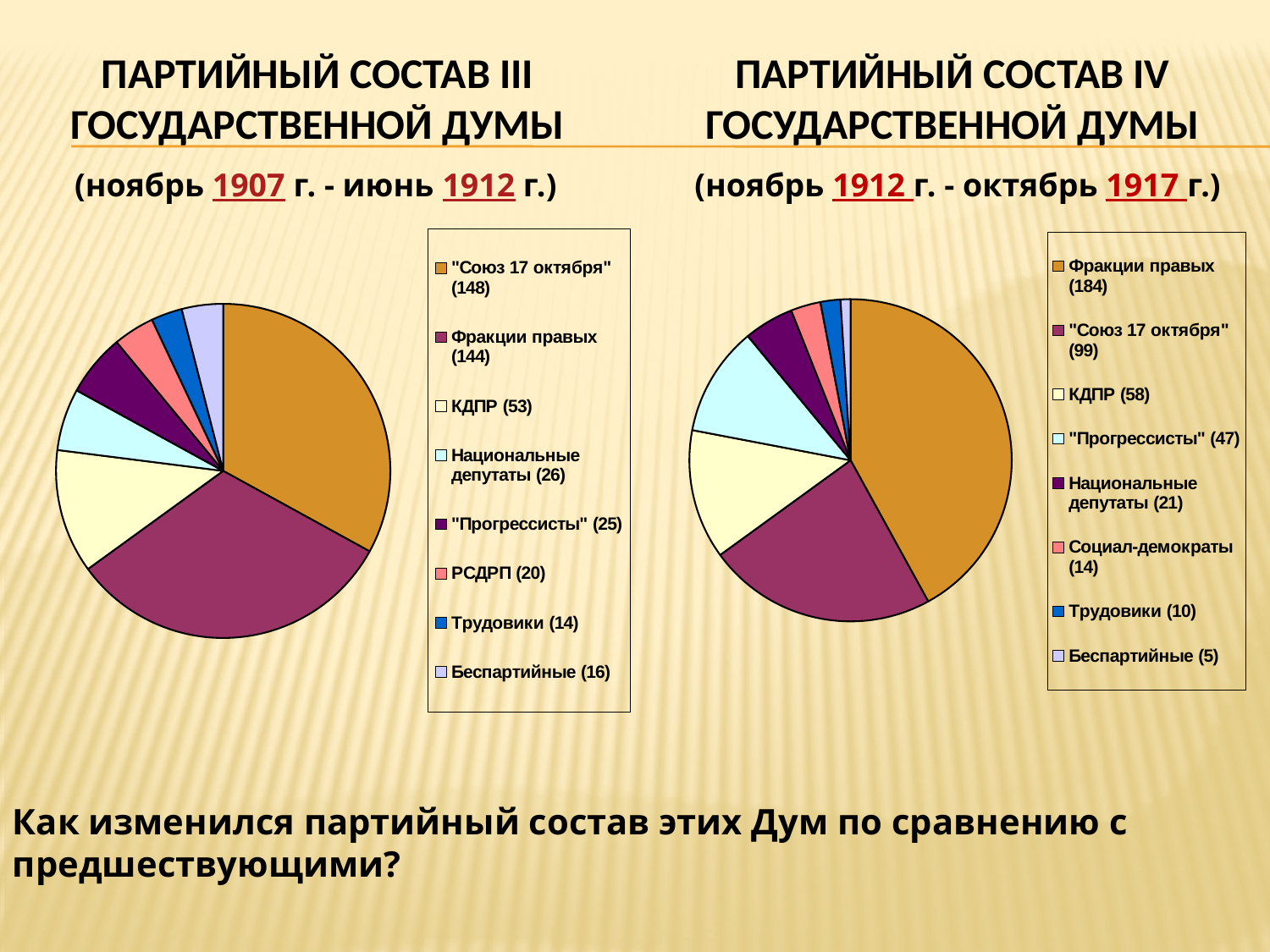
On the left chart (III Дума), what is the difference in seats between КДПР and Национальные депутаты? 27 On the left chart (III Дума), which group has the largest number of seats? "Союз 17 октября" What type of chart is used on the left for the III Государственная дума? Pie chart On the left chart (Партийный состав III Государственной думы), how many seats does "Союз 17 октября" have? 148 On the left chart (III Дума), which has more seats: РСДРП or Беспартийные? РСДРП How many groups are shown in the legend of the right chart (IV Дума)? 8 On the left chart (III Дума), which group has the smallest number of seats? Трудовики On the right chart (IV Дума), what is the difference in seats between Фракции правых and "Союз 17 октября"? 85 On the right chart (Партийный состав IV Государственной думы), how many seats do Фракции правых have? 184 On the right chart (IV Дума), how many seats do Трудовики have? 10 On the right chart (IV Дума), which group has the smallest number of seats? Беспартийные On the right chart (IV Дума), which has more seats: КДПР or "Прогрессисты"? КДПР